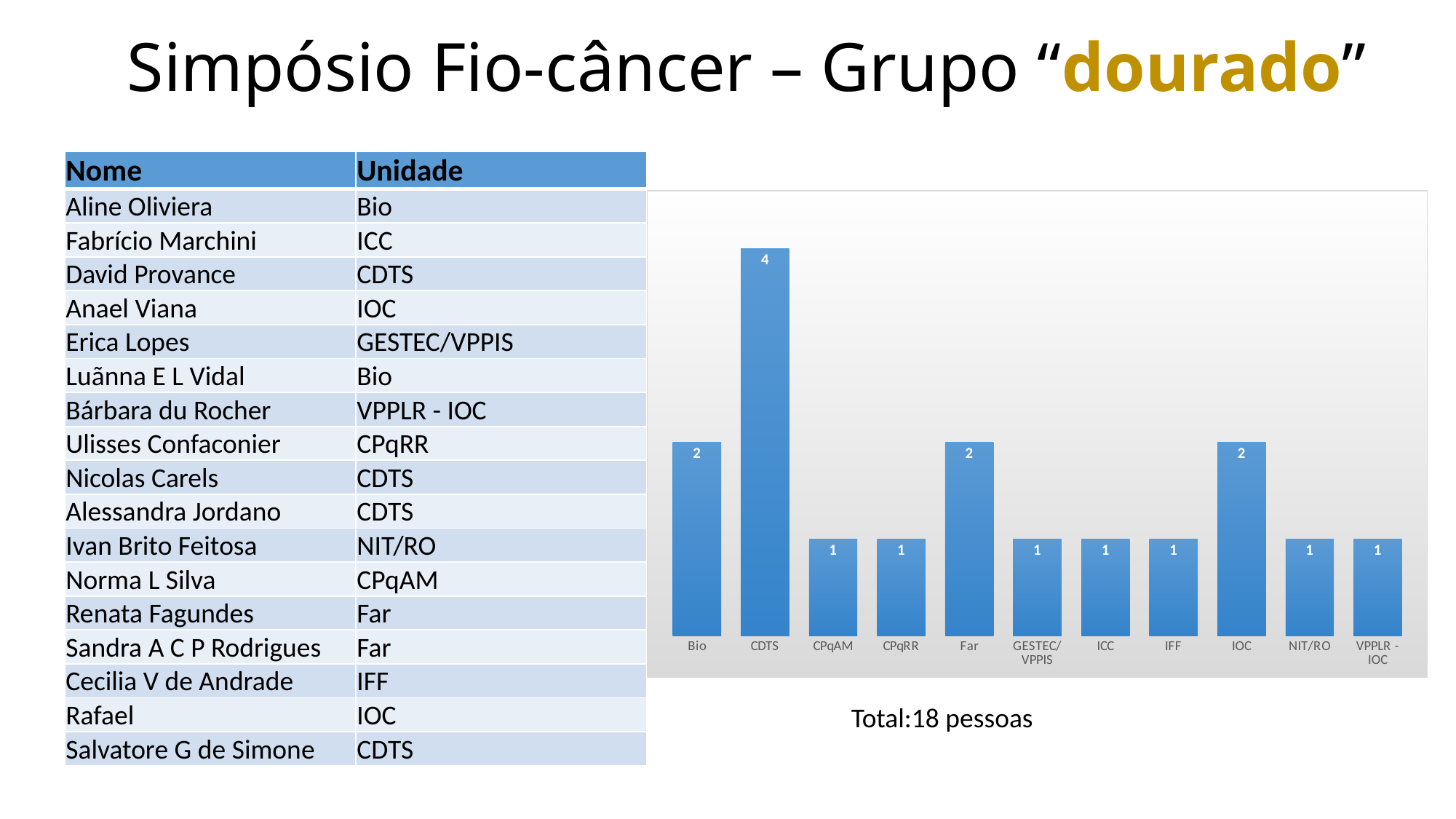
What is the value for Far in the bar chart? 2 How many categories are shown on the x axis of the bar chart? 11 Which category has the highest value in the bar chart? CDTS What is the value for Bio in the bar chart? 2 What is the difference between the values for IOC and NIT/RO? 1 What kind of chart is shown on the slide? Bar chart Which has a larger value, CPqAM or CDTS? CDTS Which has a larger value, Far or IFF? Far What is the difference between the values for CDTS and Bio? 2 What is the value for GESTEC/VPPIS in the bar chart? 1 What is the value for IOC in the bar chart? 2 What is the value for CDTS in the bar chart? 4